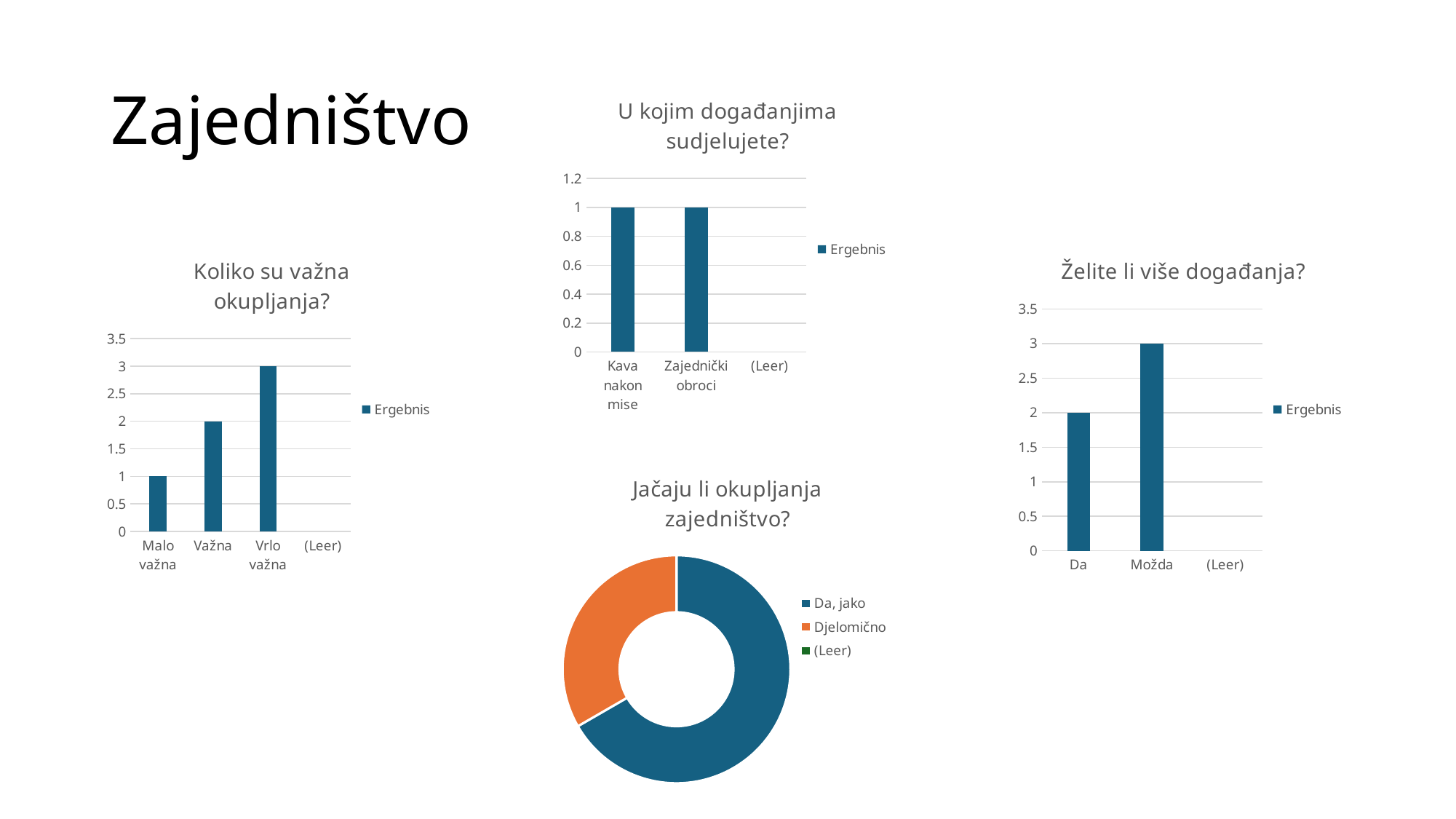
In the chart titled "Koliko su važna okupljanja?", do the bar values rise or fall from "Malo važna" to "Vrlo važna"? rise In the chart titled "Koliko su važna okupljanja?", what is the difference between the values for "Vrlo važna" and "Malo važna"? 2 In the chart titled "U kojim događanjima sudjelujete?", what is the value for "Kava nakon mise"? 1 In the chart titled "Želite li više događanja?", which is larger, the value for "Da" or the value for "Možda"? Možda In the chart titled "Koliko su važna okupljanja?", what is the value for "Vrlo važna"? 3 In the chart titled "Jačaju li okupljanja zajedništvo?", which legend entry has the largest slice? Da, jako In the chart titled "Koliko su važna okupljanja?", which category has the lowest non-empty bar? Malo važna In the chart titled "U kojim događanjima sudjelujete?", how many category labels are shown on the x axis? 3 What kind of chart is the one titled "Jačaju li okupljanja zajedništvo?"? doughnut chart In the chart titled "Želite li više događanja?", what is the value for "Možda"? 3 How many entries does the legend of the chart titled "Jačaju li okupljanja zajedništvo?" list? 3 In the chart titled "Želite li više događanja?", is the value for "Da" greater or less than 2.5? less